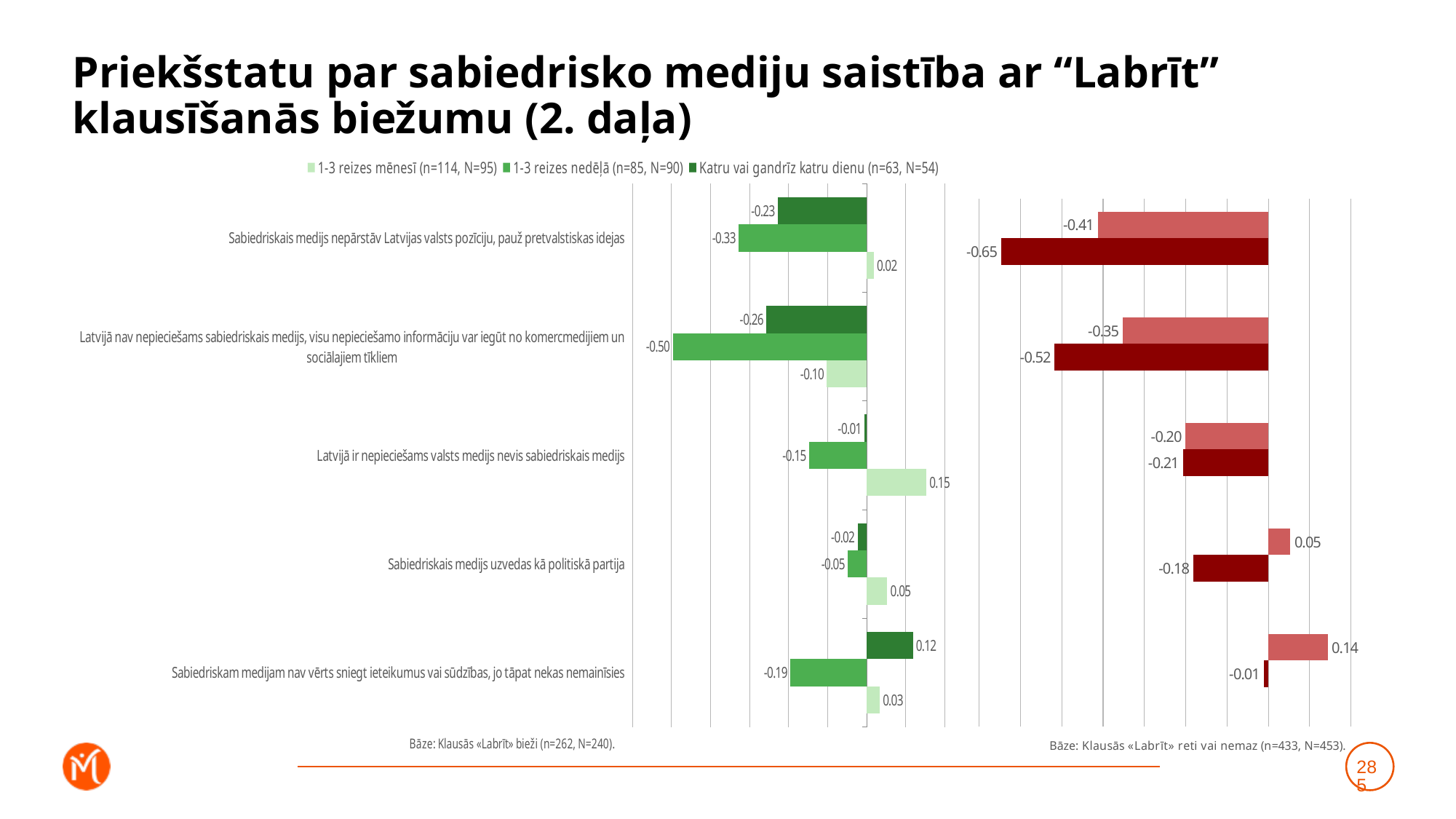
In the right (red) chart, what is the value of the lighter red bar for the category "Sabiedriskam medijam nav vērts sniegt ieteikumus vai sūdzības, jo tāpat nekas nemainīsies"? 0.14 In the left (green) chart, what is the value for the series "Katru vai gandrīz katru dienu (n=63, N=54)" for the category "Sabiedriskais medijs nepārstāv Latvijas valsts pozīciju, pauž pretvalstiskas idejas"? -0.23 What kind of chart is the left (green) chart? Bar chart In the left (green) chart, what is the difference between the "1-3 reizes mēnesī (n=114, N=95)" value and the "1-3 reizes nedēļā (n=85, N=90)" value for the category "Latvijā ir nepieciešams valsts medijs nevis sabiedriskais medijs"? 0.30 How many categories are shown in the left (green) chart? 5 How many series does the legend of the left (green) chart list? 3 In the left (green) chart, what is the value for the series "1-3 reizes mēnesī (n=114, N=95)" for the category "Latvijā ir nepieciešams valsts medijs nevis sabiedriskais medijs"? 0.15 In the left (green) chart, what is the value for the series "1-3 reizes nedēļā (n=85, N=90)" for the category "Latvijā nav nepieciešams sabiedriskais medijs, visu nepieciešamo informāciju var iegūt no komercmedijiem un sociālajiem tīkliem"? -0.50 In the left (green) chart, which category has the lowest value for the series "1-3 reizes nedēļā (n=85, N=90)"? Latvijā nav nepieciešams sabiedriskais medijs, visu nepieciešamo informāciju var iegūt no komercmedijiem un sociālajiem tīkliem In the right (red) chart, what is the value of the dark red bar for the category "Sabiedriskais medijs nepārstāv Latvijas valsts pozīciju, pauž pretvalstiskas idejas"? -0.65 In the left (green) chart, which category has the highest value for the series "Katru vai gandrīz katru dienu (n=63, N=54)"? Sabiedriskam medijam nav vērts sniegt ieteikumus vai sūdzības, jo tāpat nekas nemainīsies